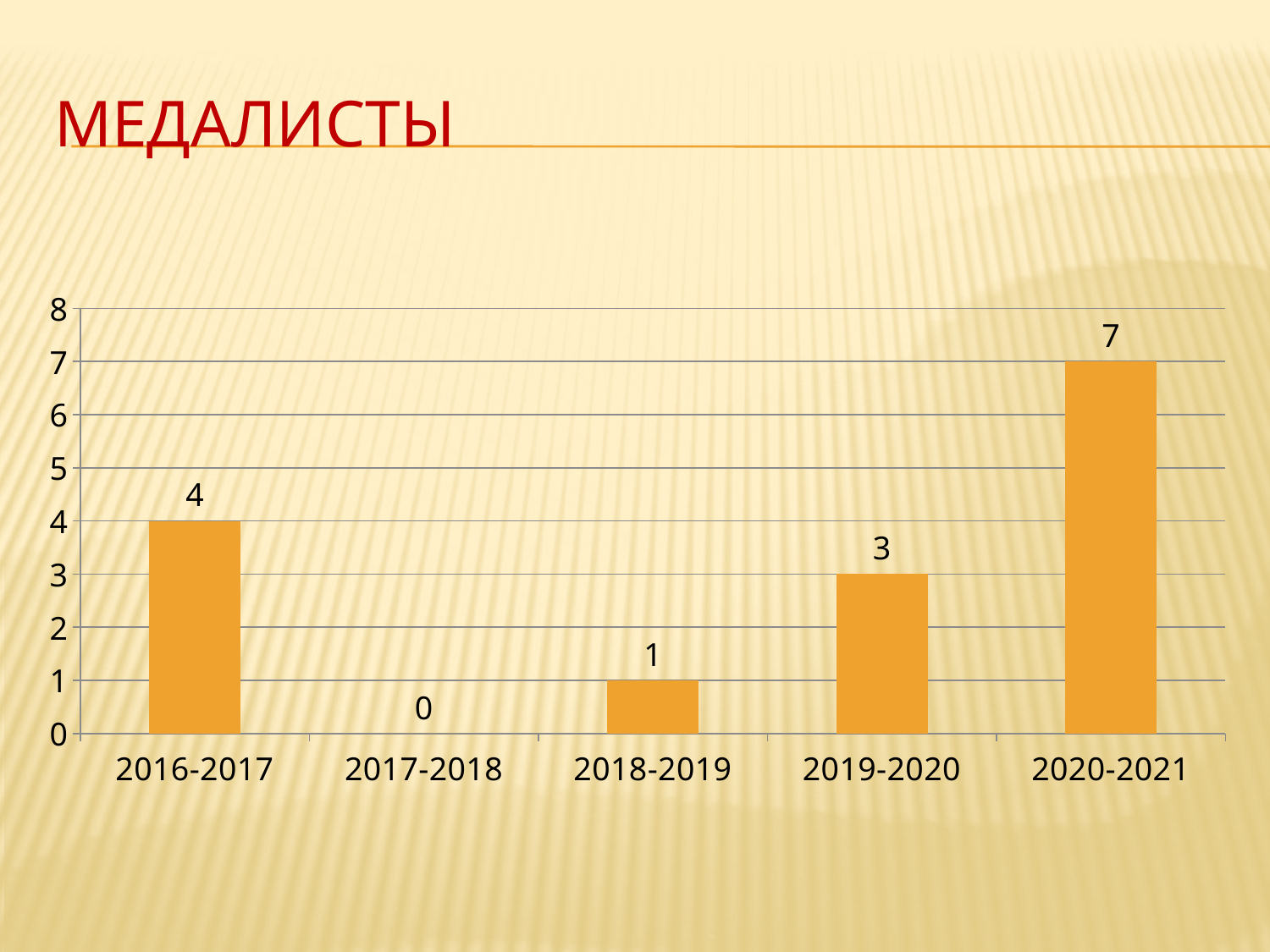
Which category has the lowest value? 2017-2018 What is the value for 2020-2021? 7 What is the difference between the values for 2020-2021 and 2016-2017? 3 What is the title of the slide? МЕДАЛИСТЫ Which is larger, the value for 2016-2017 or the value for 2019-2020? 2016-2017 What is the value for 2018-2019? 1 Which category has the highest value? 2020-2021 What kind of chart is shown on the slide? bar chart What is the value for 2017-2018? 0 How many categories are shown on the x axis? 5 What is the value for 2019-2020? 3 What is the value for 2016-2017? 4